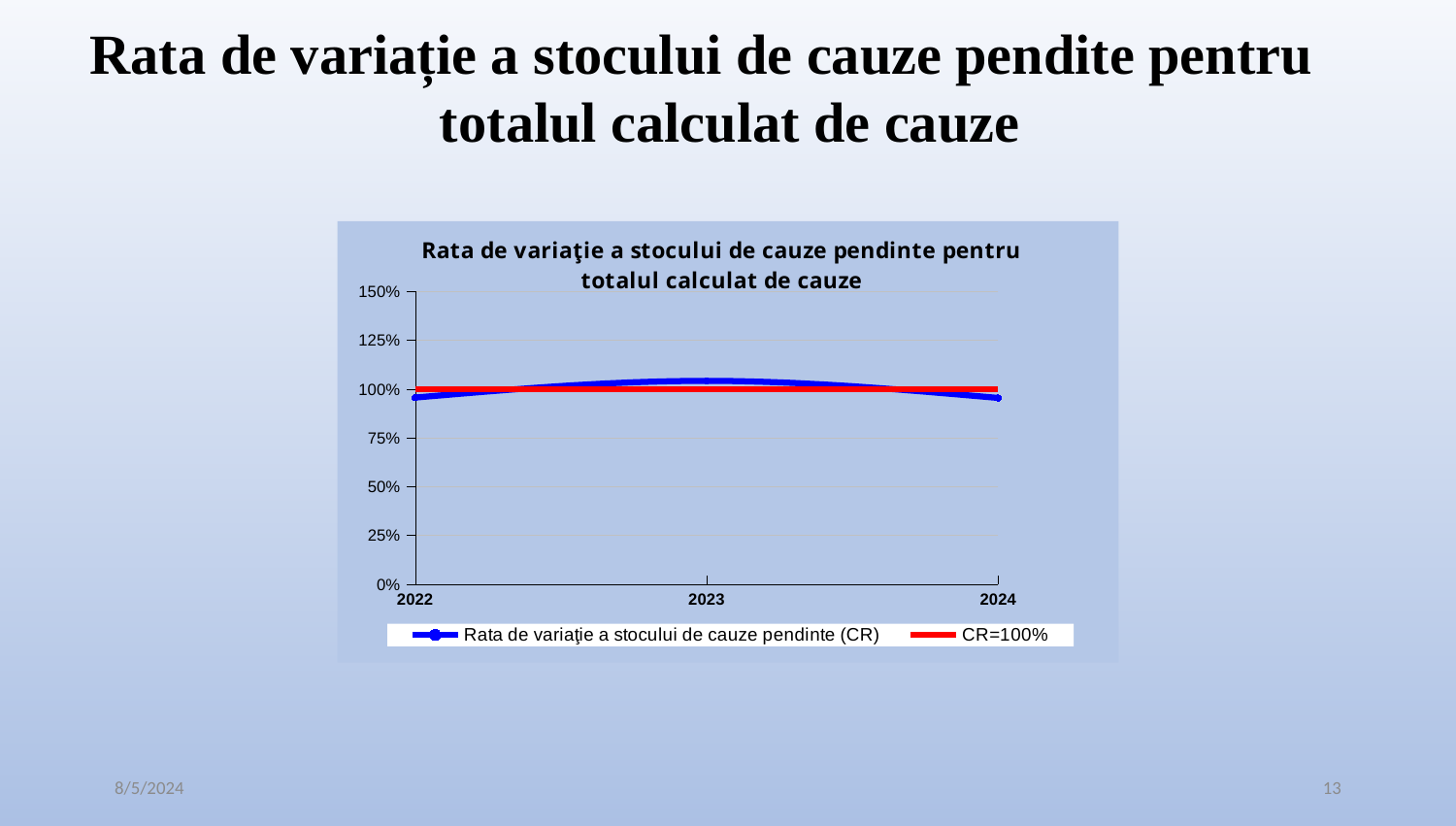
Is the value of 'Rata de variaţie a stocului de cauze pendinte (CR)' in 2024 greater or less than 125%? less What colour is the line for the series 'CR=100%'? red Is the value of 'Rata de variaţie a stocului de cauze pendinte (CR)' in 2022 greater or less than 75%? greater How many series does the chart legend list? 2 Is the value of 'Rata de variaţie a stocului de cauze pendinte (CR)' in 2023 greater or less than 125%? less Does the blue 'Rata de variaţie a stocului de cauze pendinte (CR)' line rise or fall from 2022 to 2023? rise Does the blue 'Rata de variaţie a stocului de cauze pendinte (CR)' line rise or fall from 2023 to 2024? fall What kind of chart is shown on the slide? line chart Which year has the highest value for the series 'Rata de variaţie a stocului de cauze pendinte (CR)'? 2023 At what constant level is the red 'CR=100%' line plotted? 100% How many years are shown on the x axis of the chart? 3 What is the title of the chart? Rata de variaţie a stocului de cauze pendinte pentru totalul calculat de cauze